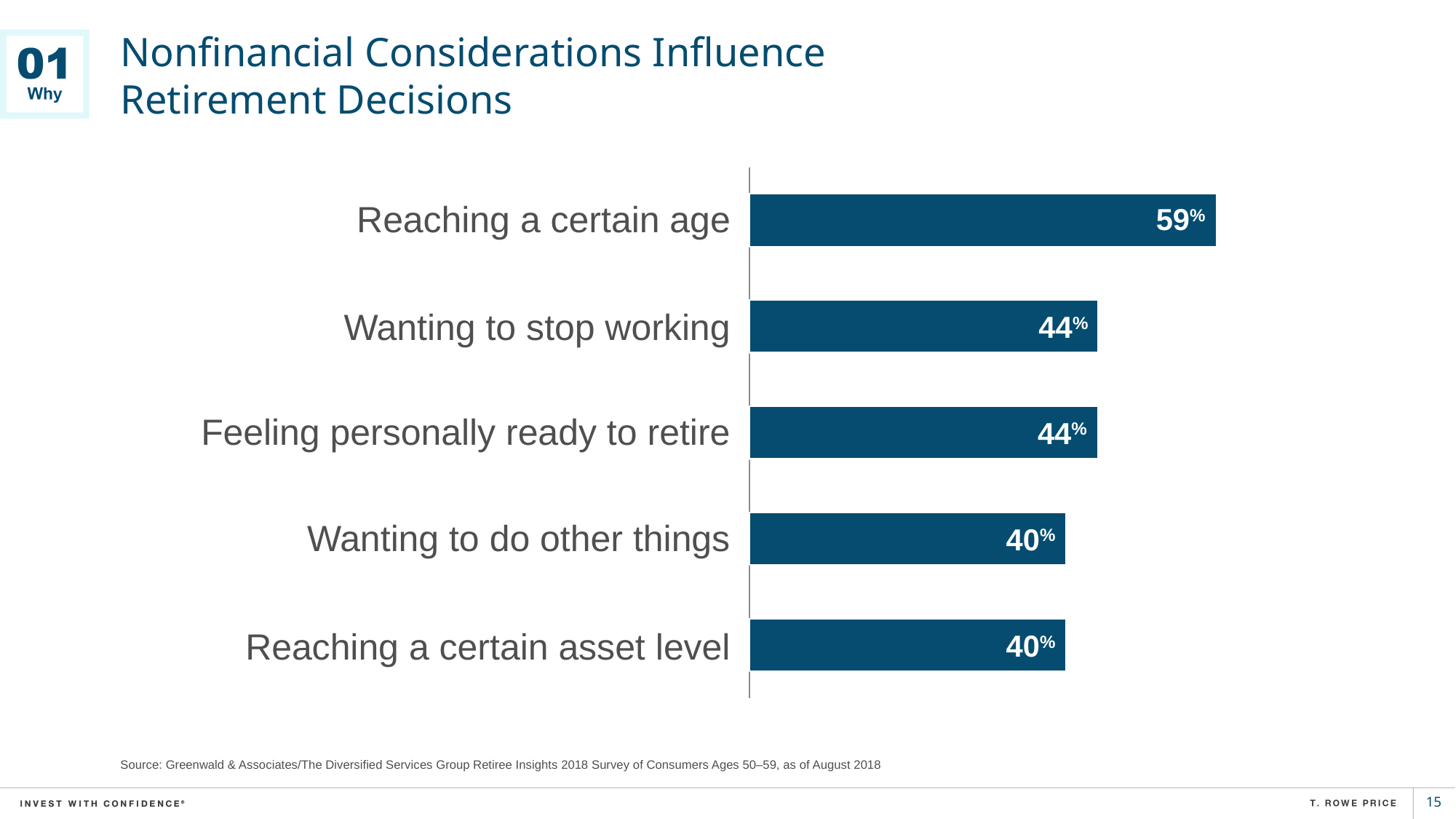
What is the value for Reaching a certain asset level? 40% Which is larger, the value for Reaching a certain age or the value for Reaching a certain asset level? Reaching a certain age What is the value for Feeling personally ready to retire? 44% What is the value for Reaching a certain age? 59% What is the difference between the values for Feeling personally ready to retire and Wanting to do other things? 4% What is the title of the slide containing the chart? Nonfinancial Considerations Influence Retirement Decisions What is the value for Wanting to stop working? 44% What is the difference between the values for Reaching a certain age and Wanting to stop working? 15% What is the value for Wanting to do other things? 40% What kind of chart is shown on the slide? Bar chart Which category has the highest value? Reaching a certain age How many categories are shown in the chart? 5